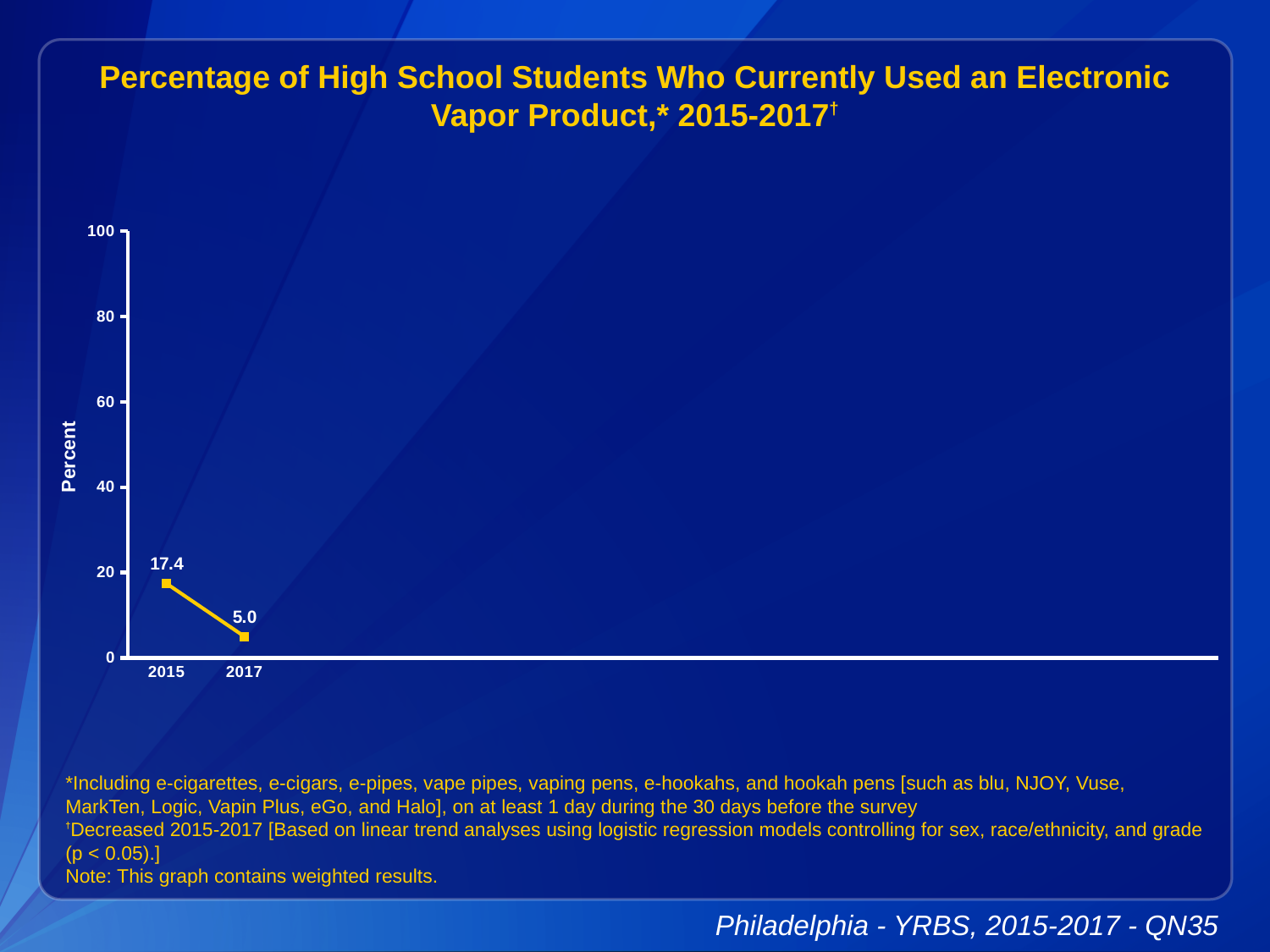
What is the maximum value shown on the y axis? 100 Which is larger, the value for 2015 or the value for 2017? 2015 How many data points are plotted on the chart? 2 What is the value for 2017? 5.0 What is the difference between the 2015 and 2017 values? 12.4 What kind of chart is shown on the slide? line chart Is the value for 2015 greater or less than 20? less Which year has the lowest value? 2017 Do the values rise or fall from 2015 to 2017? fall What is the value for 2015? 17.4 Which year has the highest value? 2015 What is the label on the y axis? Percent